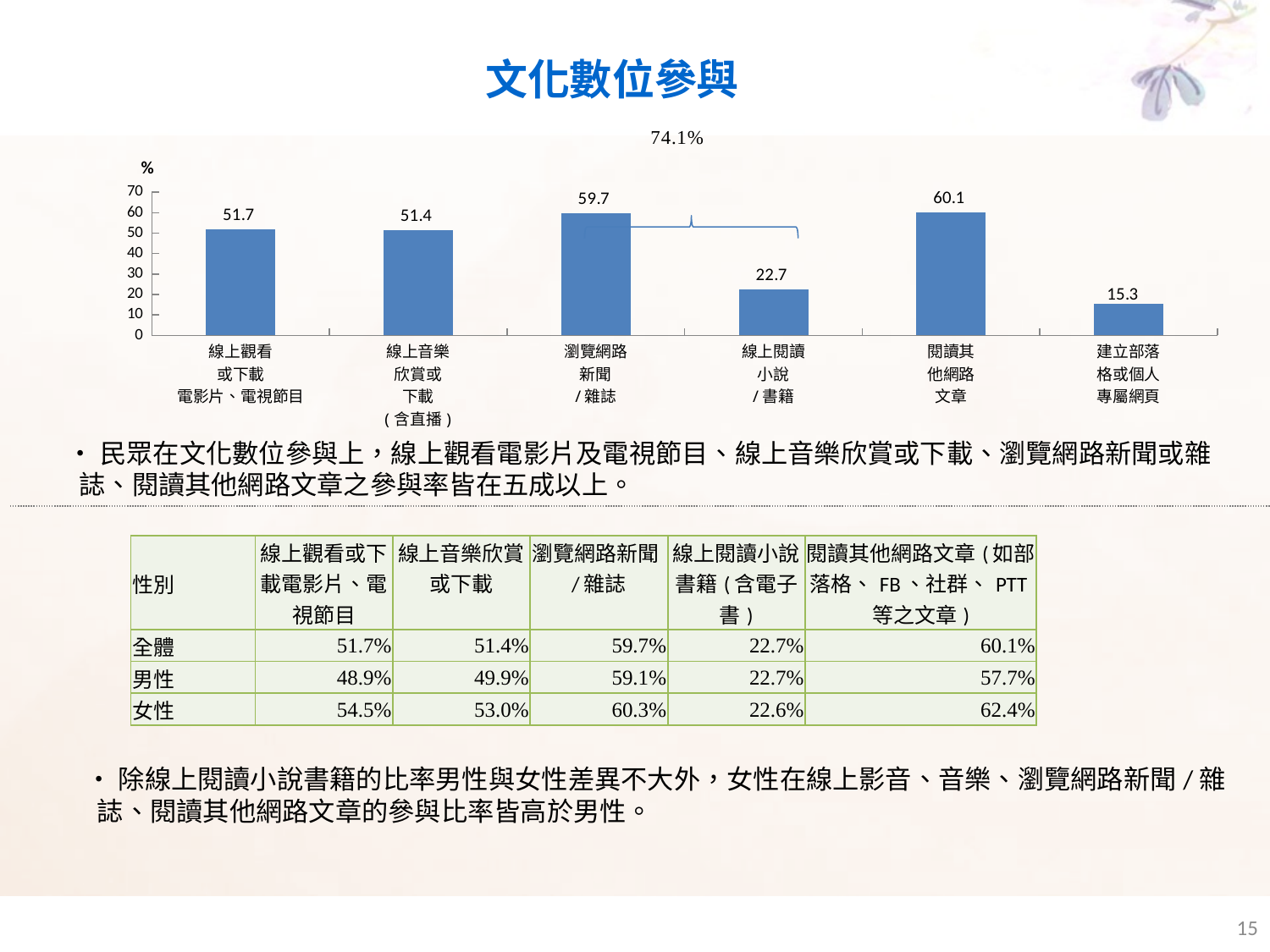
Which is larger, the value for 線上觀看或下載電影片、電視節目 or the value for 線上閱讀小說/書籍? 線上觀看或下載電影片、電視節目 Which category has the highest value in the chart? 閱讀其他網路文章 What is the value for 線上觀看或下載電影片、電視節目 in the chart? 51.7 What is the difference between the values for 閱讀其他網路文章 and 瀏覽網路新聞/雜誌? 0.4 What is the value for 建立部落格或個人專屬網頁 in the chart? 15.3 Is the value for 線上音樂欣賞或下載 greater or less than 50? greater What is the difference between the values for 線上閱讀小說/書籍 and 建立部落格或個人專屬網頁? 7.4 What is the value for 線上閱讀小說/書籍 in the chart? 22.7 How many categories are shown in the chart? 6 Which category has the lowest value in the chart? 建立部落格或個人專屬網頁 What unit label is shown at the top of the vertical axis of the chart? % What kind of chart is shown on the slide? bar chart